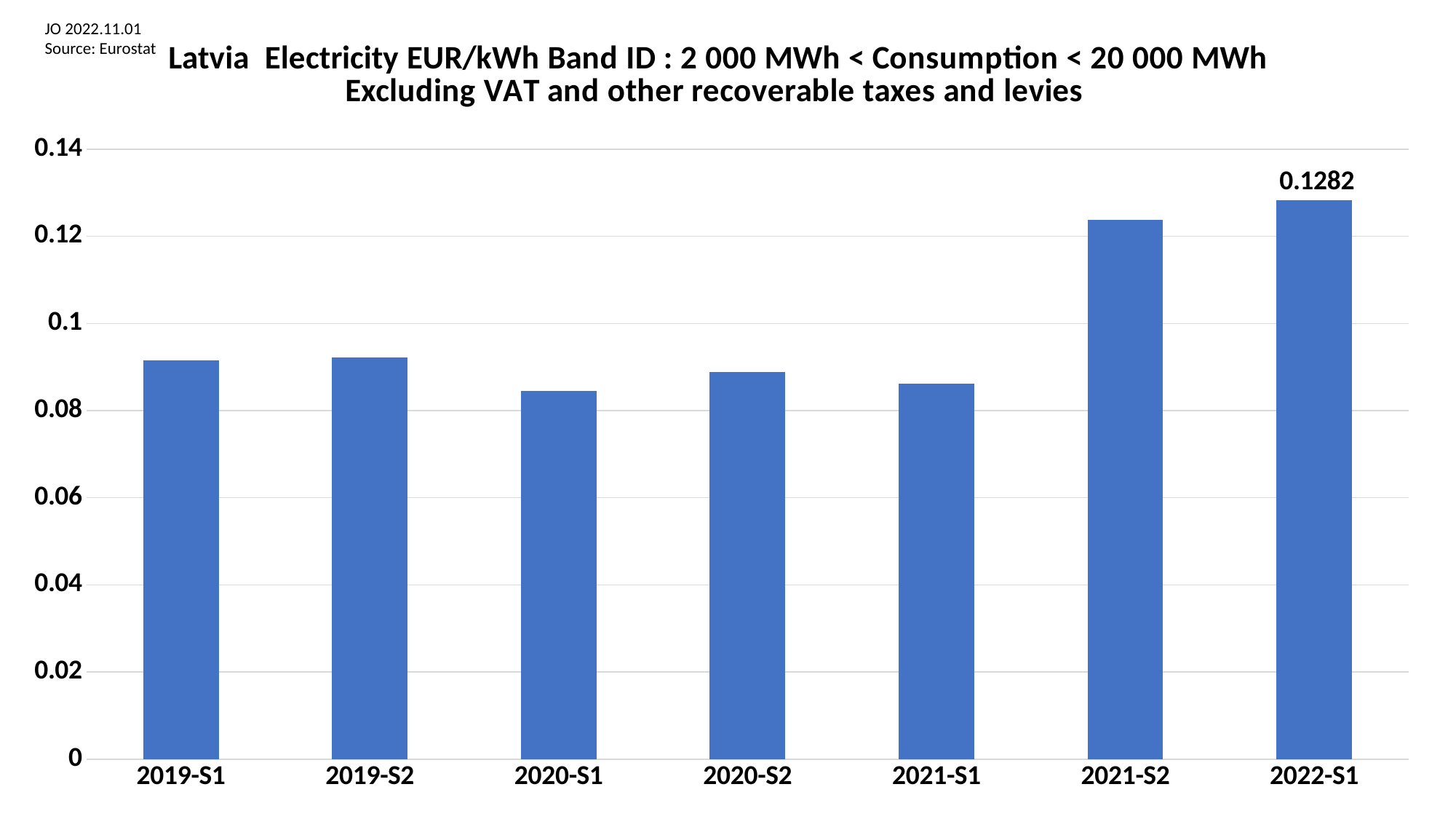
Which period has the lowest value? 2020-S1 Do the values rise or fall from 2021-S1 to 2022-S1? Rise Is the value for 2019-S1 greater or less than 0.08? greater Is the value for 2021-S2 greater or less than 0.12? greater Which is larger, the value for 2021-S1 or the value for 2021-S2? 2021-S2 Which period has the highest value? 2022-S1 Which is larger, the value for 2020-S1 or the value for 2020-S2? 2020-S2 What is the source cited on the slide? Eurostat What kind of chart is this? Bar chart How many periods are shown on the x axis? 7 Is the value for 2020-S1 greater or less than 0.1? less What is the value for 2022-S1? 0.1282